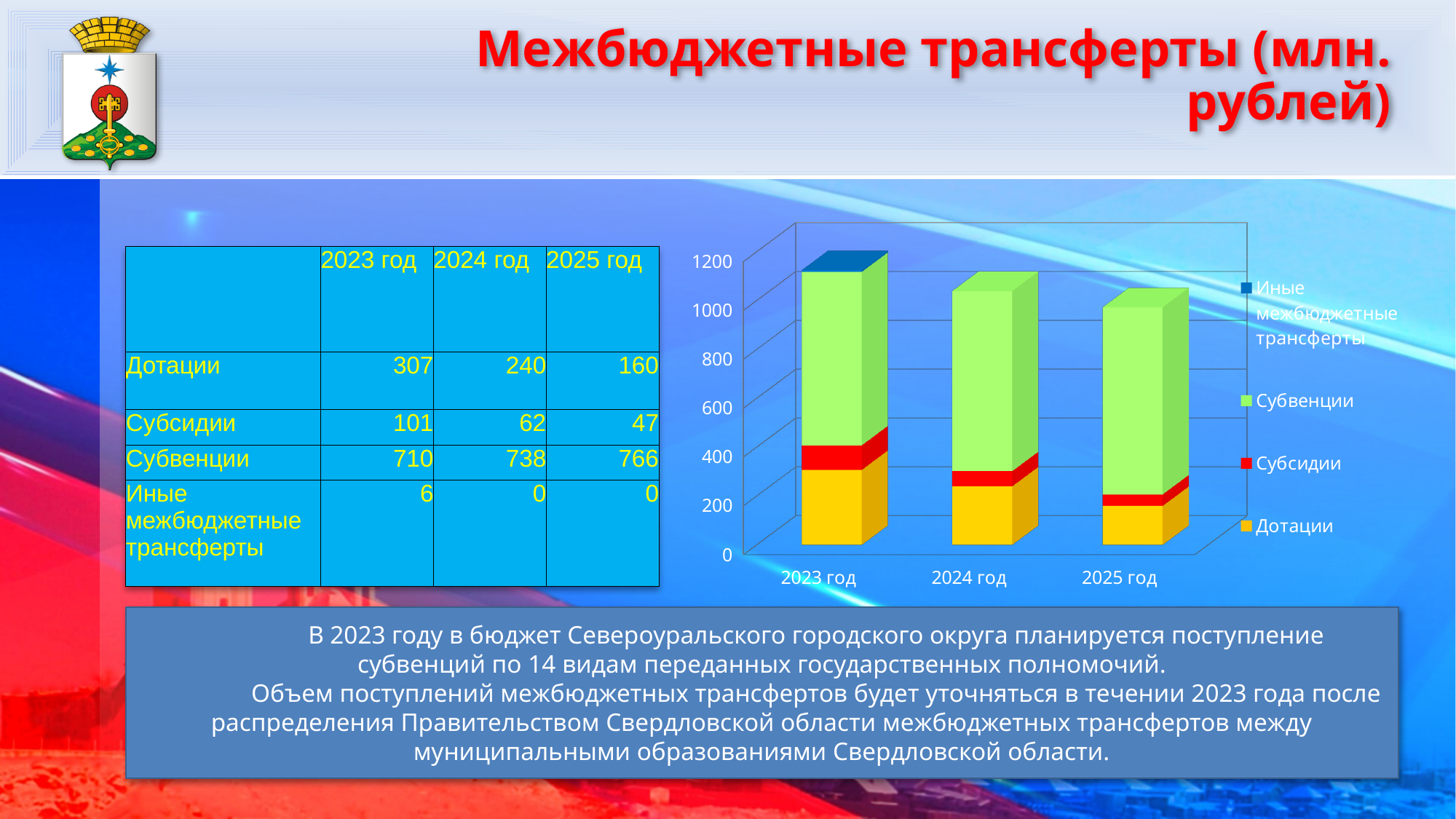
In which year is the value of Дотации the lowest? 2025 год What kind of chart is shown on the slide? stacked bar chart Which is larger: Субсидии in 2023 год or Субсидии in 2025 год? Субсидии in 2023 год Do the total stacked bar heights rise or fall from 2023 год to 2025 год? fall What is the value of Субвенции for 2025 год? 766 What is the total of the stacked bar for 2024 год? 1040 What is the value of Субсидии for 2024 год? 62 What is the difference between Дотации in 2023 год and 2025 год? 147 What is the value of Дотации for 2023 год? 307 In which year is the value of Субвенции the highest? 2025 год How many series does the chart legend list? 4 How many years (categories) are shown on the x axis of the chart? 3